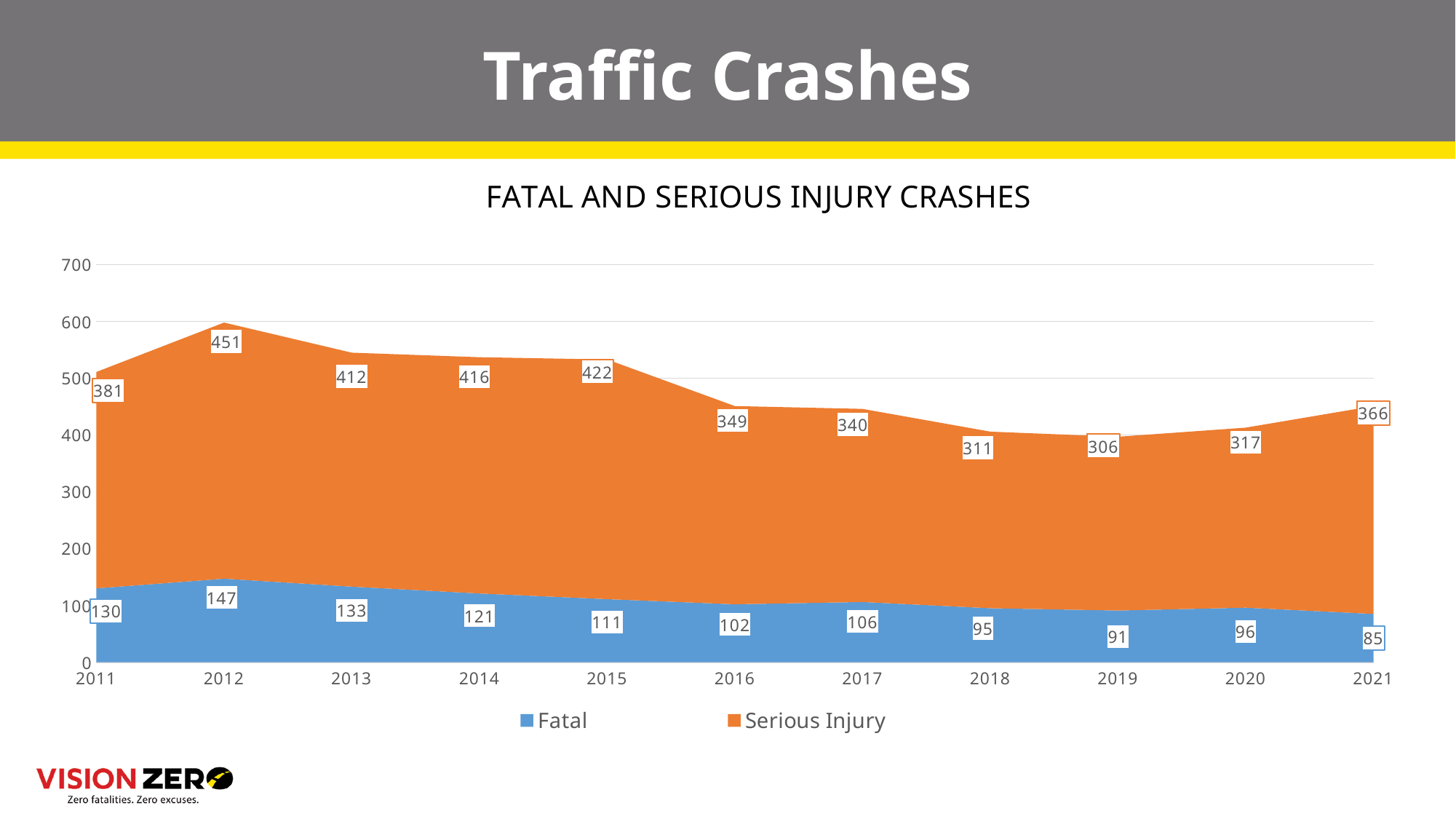
What is the Fatal value for 2021? 85 What is the combined total of Fatal and Serious Injury crashes for 2021? 451 Which year has the highest Serious Injury value? 2012 What kind of chart is shown? Stacked area chart How many years are shown on the x axis? 11 What is the Serious Injury value for 2019? 306 What is the Fatal value for 2012? 147 Which is larger, the Fatal value for 2017 or the Fatal value for 2016? 2017 How many series does the legend list? 2 Which year has the lowest Serious Injury value? 2019 Which year has the lowest Fatal value? 2021 What is the difference between the Serious Injury values for 2012 and 2011? 70